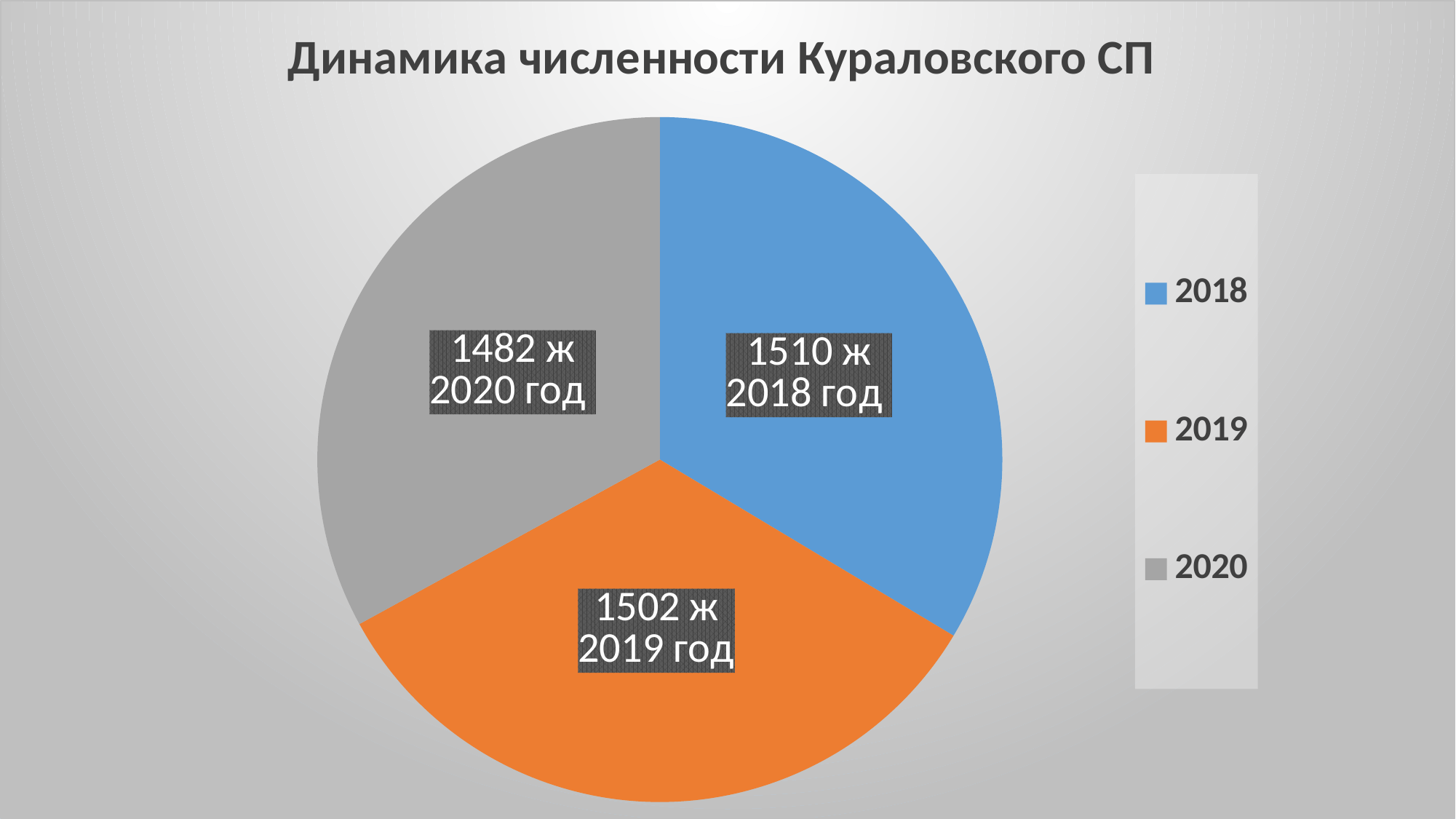
How many slices does the pie chart have? 3 What value is shown for the 2020 slice? 1482 ж How many entries does the legend list? 3 What kind of chart is shown on the slide? pie chart Which year has the highest value in the pie chart? 2018 Which is larger, the value for 2018 or the value for 2019? 2018 What is the title of the chart? Динамика численности Кураловского СП What is the difference between the values for 2018 and 2020? 28 What is the difference between the values for 2019 and 2020? 20 What value is shown for the 2019 slice? 1502 ж Which year has the lowest value in the pie chart? 2020 What value is shown for the 2018 slice? 1510 ж